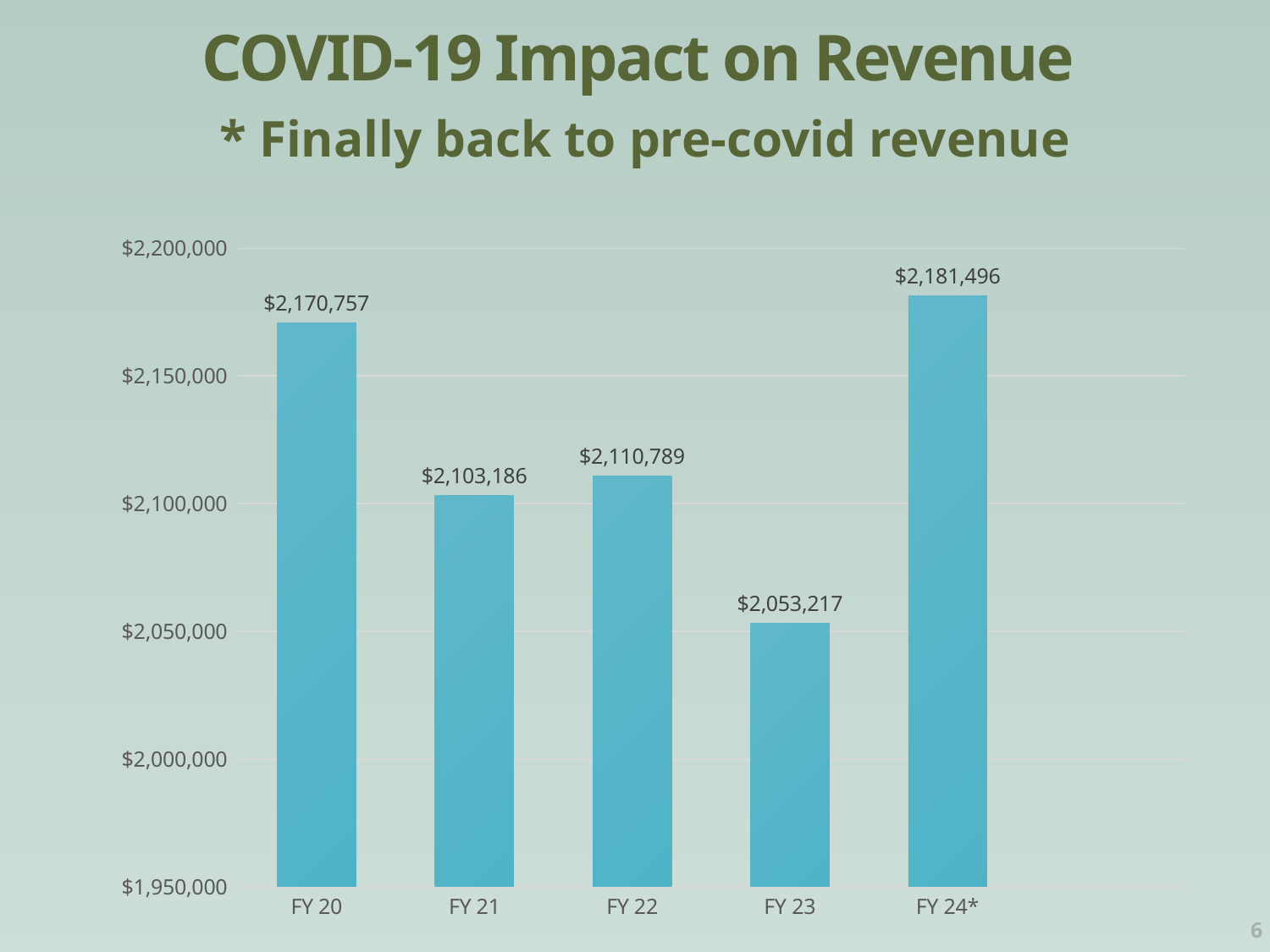
What is the difference between the FY 24* revenue and the FY 20 revenue? $10,739 What is the revenue value shown for FY 24*? $2,181,496 What is the title of the slide containing the chart? COVID-19 Impact on Revenue Which fiscal year has the lowest revenue? FY 23 What is the difference between the FY 22 revenue and the FY 21 revenue? $7,603 What is the revenue value shown for FY 20? $2,170,757 How many fiscal years are shown on the chart? 5 Is the value for FY 23 greater or less than $2,100,000? less Which is larger, the revenue for FY 21 or the revenue for FY 22? FY 22 What kind of chart is shown on the slide? bar chart What is the revenue value shown for FY 23? $2,053,217 Which fiscal year has the highest revenue? FY 24*